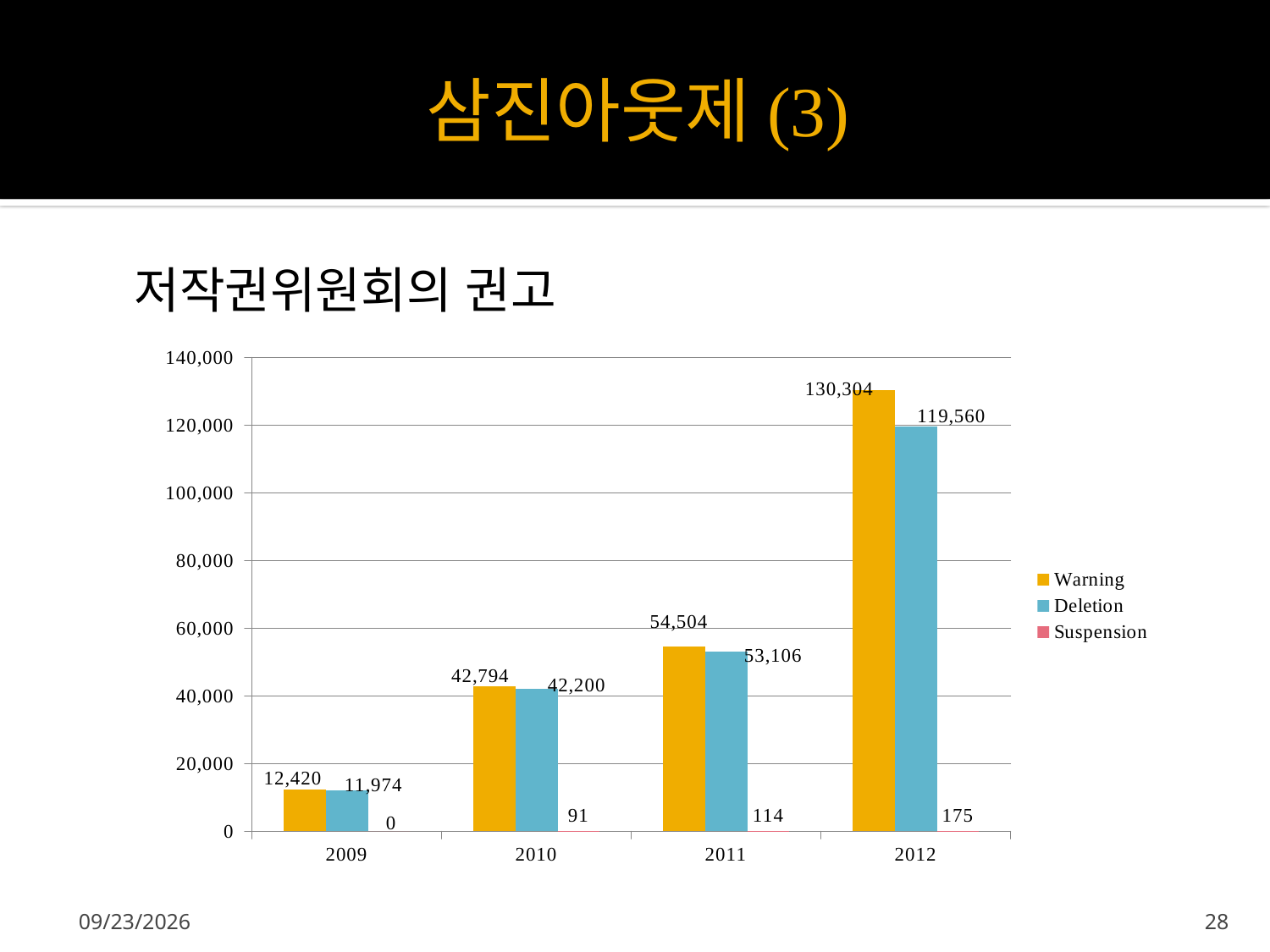
How many years are shown on the x axis? 4 What is the Suspension value for 2011? 114 Which year has the lowest Deletion value? 2009 Which year has the highest Warning value? 2012 Is the Deletion value for 2012 greater or less than 100,000? greater What is the difference between the Warning and Deletion values in 2012? 10,744 What kind of chart is shown on the slide? bar chart What is the Deletion value for 2010? 42,200 Which is larger in 2011, the Warning value or the Deletion value? Warning Do the Warning values rise or fall from 2009 to 2012? rise What is the Warning value for 2012? 130,304 How many series does the legend list? 3